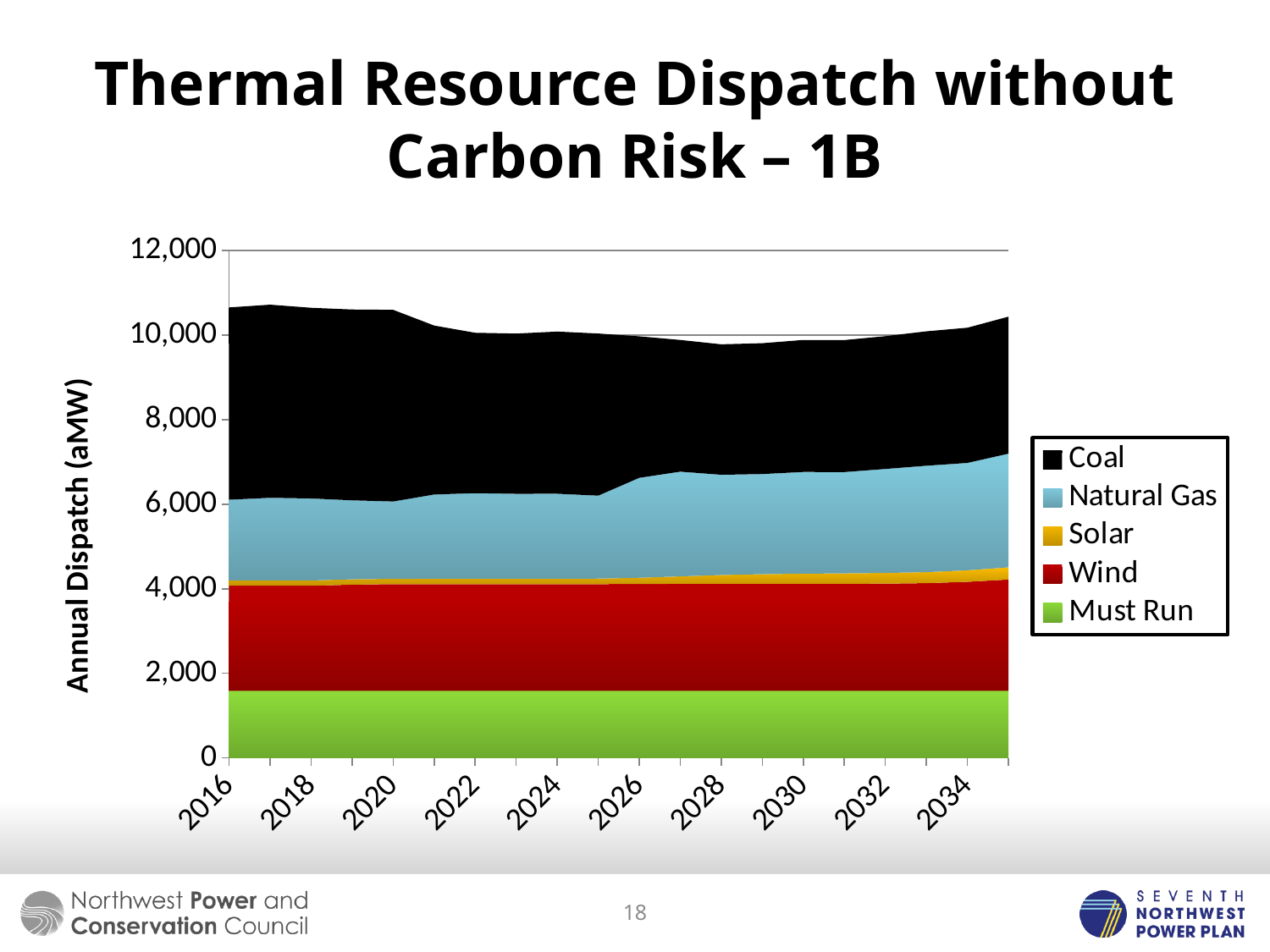
Which series contributes the largest amount of dispatch in 2016? Coal Is the total annual dispatch in 2016 greater or less than 10,000? greater Is the total annual dispatch in 2028 greater or less than 12,000? less Is the Must Run dispatch in 2016 greater or less than 2,000? less Does the Natural Gas dispatch rise or fall from 2016 to 2034? rise Which contributes more dispatch in 2020, Wind or Must Run? Wind Which series contributes the smallest amount of dispatch across the years shown? Solar What is the label on the vertical axis? Annual Dispatch (aMW) How many series does the legend list? 5 How many year labels are shown on the x axis? 10 What kind of chart is shown on the slide? Stacked area chart Which series is shown in black in the chart? Coal